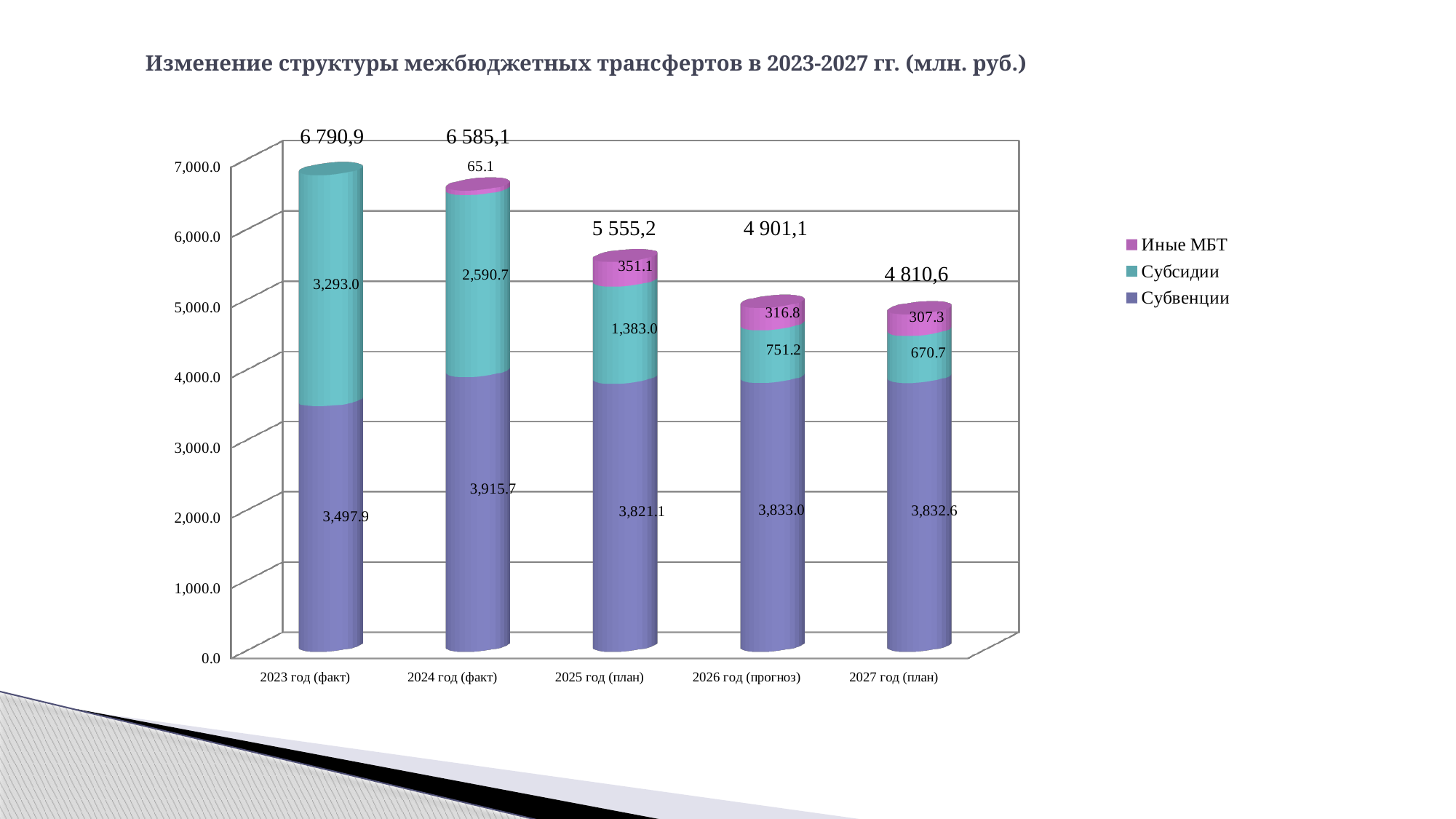
What type of chart is shown on the slide? Stacked bar chart What is the value of Субвенции for 2023 год (факт)? 3,497.9 What is the value of Субсидии for 2025 год (план)? 1,383.0 What is the total shown above the bar for 2027 год (план)? 4 810,6 How many categories (years) are shown on the x axis? 5 Which year has the lowest value for Субсидии? 2027 год (план) Which is larger: Субвенции in 2024 год (факт) or Субвенции in 2025 год (план)? 2024 год (факт) Which year has the highest total of intergovernmental transfers? 2023 год (факт) What is the value of Иные МБТ for 2026 год (прогноз)? 316.8 What is the difference between the Субсидии values for 2023 год (факт) and 2024 год (факт)? 702.3 Do the bar totals rise or fall from 2023 to 2027? Fall How many series does the legend list? 3